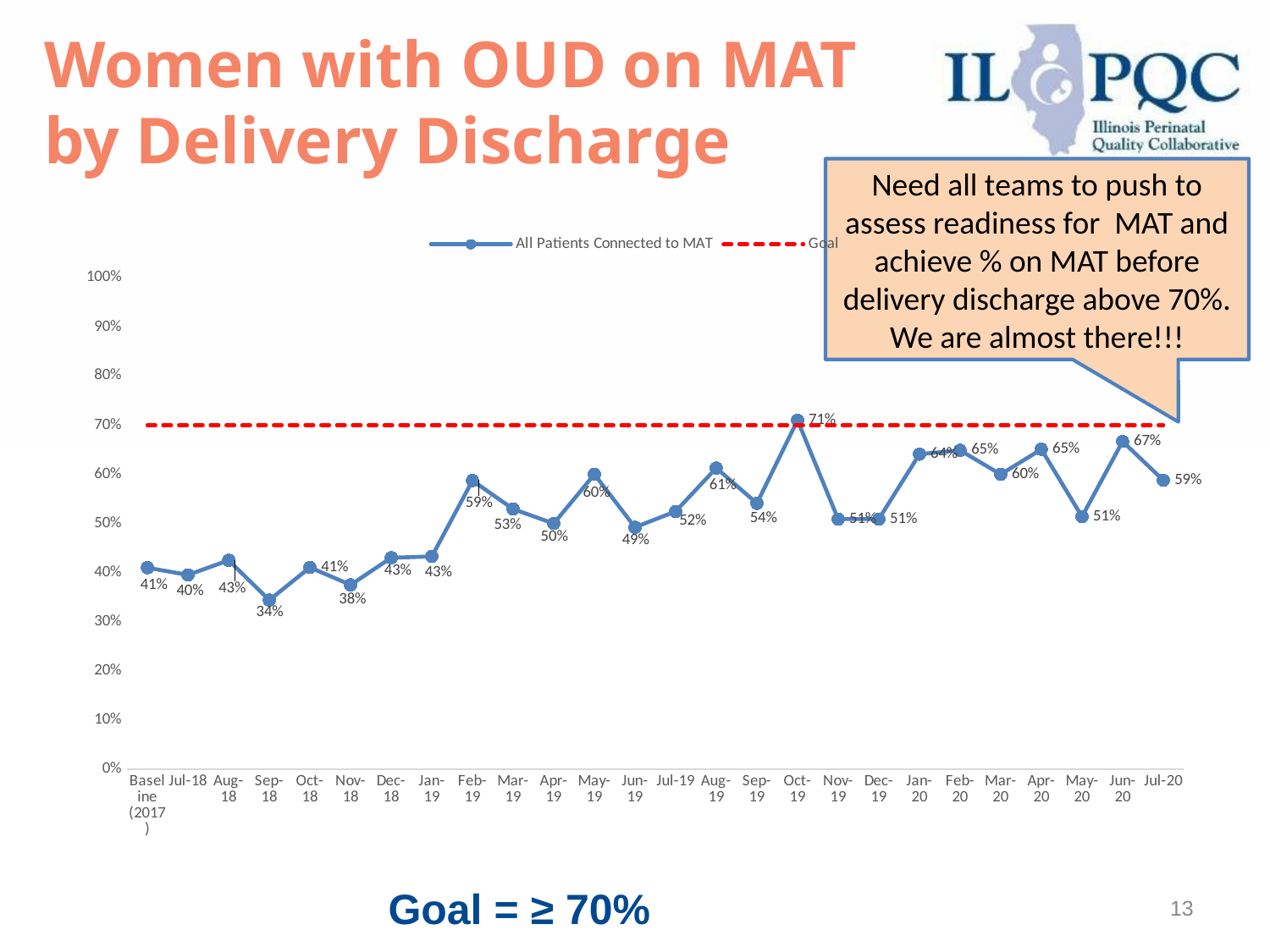
Which month has the highest value for All Patients Connected to MAT? Oct-19 Which is larger, the value for Jan-20 or the value for May-20? Jan-20 What is the difference between the values for Jun-20 and Jul-20? 8% What is the value for Sep-18? 34% At what value is the dashed Goal line drawn? 70% Which month has the lowest value for All Patients Connected to MAT? Sep-18 How many data points are plotted for All Patients Connected to MAT? 26 What is the value for Oct-19? 71% What is the value for Jul-20? 59% How many series does the legend list? 2 What is the value for Feb-19? 59% What kind of chart is shown on the slide? Line chart